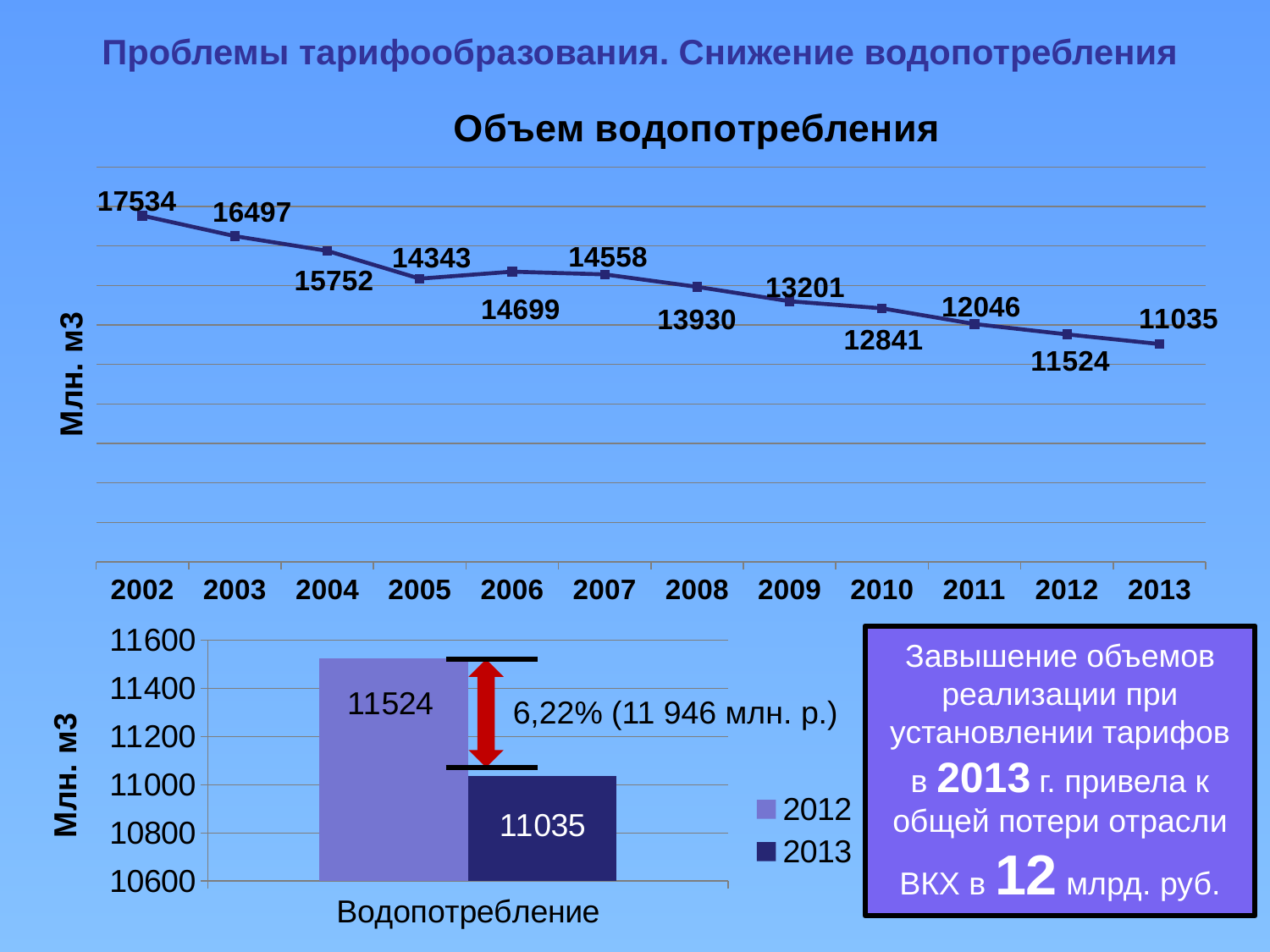
In the line chart 'Объем водопотребления', which year has the lowest value? 2013 In the line chart 'Объем водопотребления', what is the value for 2002? 17534 In the bar chart at the bottom of the slide, what is the value for 2013? 11035 What type of chart is the chart at the bottom of the slide? bar chart In the line chart 'Объем водопотребления', which is larger, the value for 2006 or the value for 2007? 2006 In the bar chart at the bottom of the slide, what is the difference between the 2012 and 2013 values? 489 In the line chart 'Объем водопотребления', what is the value for 2009? 13201 In the line chart 'Объем водопотребления', which year has the highest value? 2002 In the line chart 'Объем водопотребления', how many years are plotted on the x axis? 12 In the line chart 'Объем водопотребления', what is the difference between the values for 2002 and 2003? 1037 In the bar chart at the bottom of the slide, how many series does the legend list? 2 In the line chart 'Объем водопотребления', do the values generally rise or fall from 2002 to 2013? fall